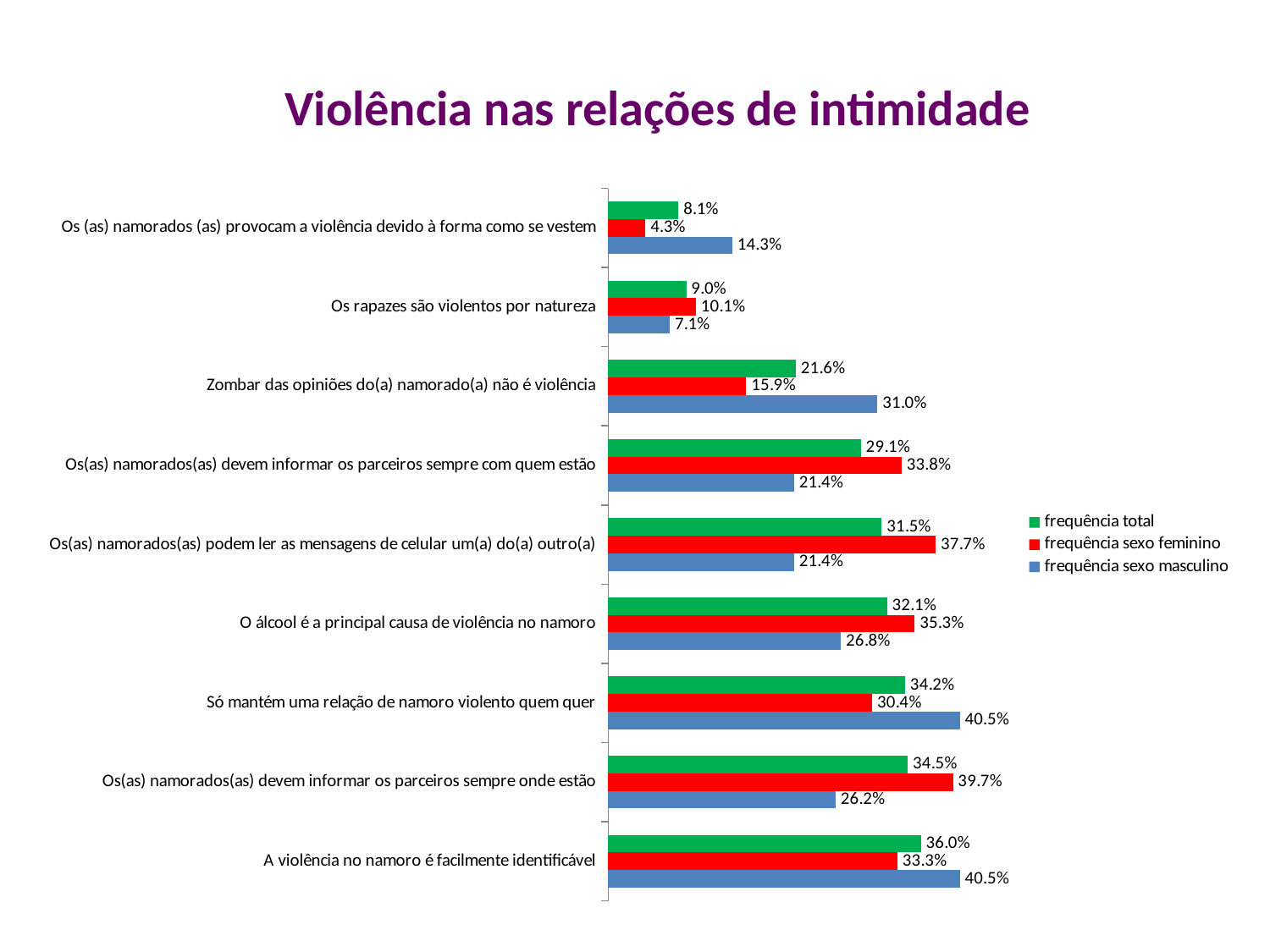
What is the 'frequência total' value for 'O álcool é a principal causa de violência no namoro'? 32.1% Which statement has the highest 'frequência sexo feminino' value? Os(as) namorados(as) devem informar os parceiros sempre onde estão Which statement has the lowest 'frequência sexo masculino' value? Os rapazes são violentos por natureza What is the 'frequência sexo feminino' value for 'Os(as) namorados(as) podem ler as mensagens de celular um(a) do(a) outro(a)'? 37.7% Which statement has the lowest 'frequência total' value? Os (as) namorados (as) provocam a violência devido à forma como se vestem How many categories (statements) are plotted on the chart? 9 What is the 'frequência sexo masculino' value for 'Os (as) namorados (as) provocam a violência devido à forma como se vestem'? 14.3% What type of chart is shown on the slide? bar chart For 'Zombar das opiniões do(a) namorado(a) não é violência', which is larger: the 'frequência sexo feminino' or the 'frequência sexo masculino' value? frequência sexo masculino How many series does the legend list? 3 What is the difference between the 'frequência sexo masculino' and 'frequência sexo feminino' values for 'Os (as) namorados (as) provocam a violência devido à forma como se vestem'? 10.0% What is the title of the chart? Violência nas relações de intimidade